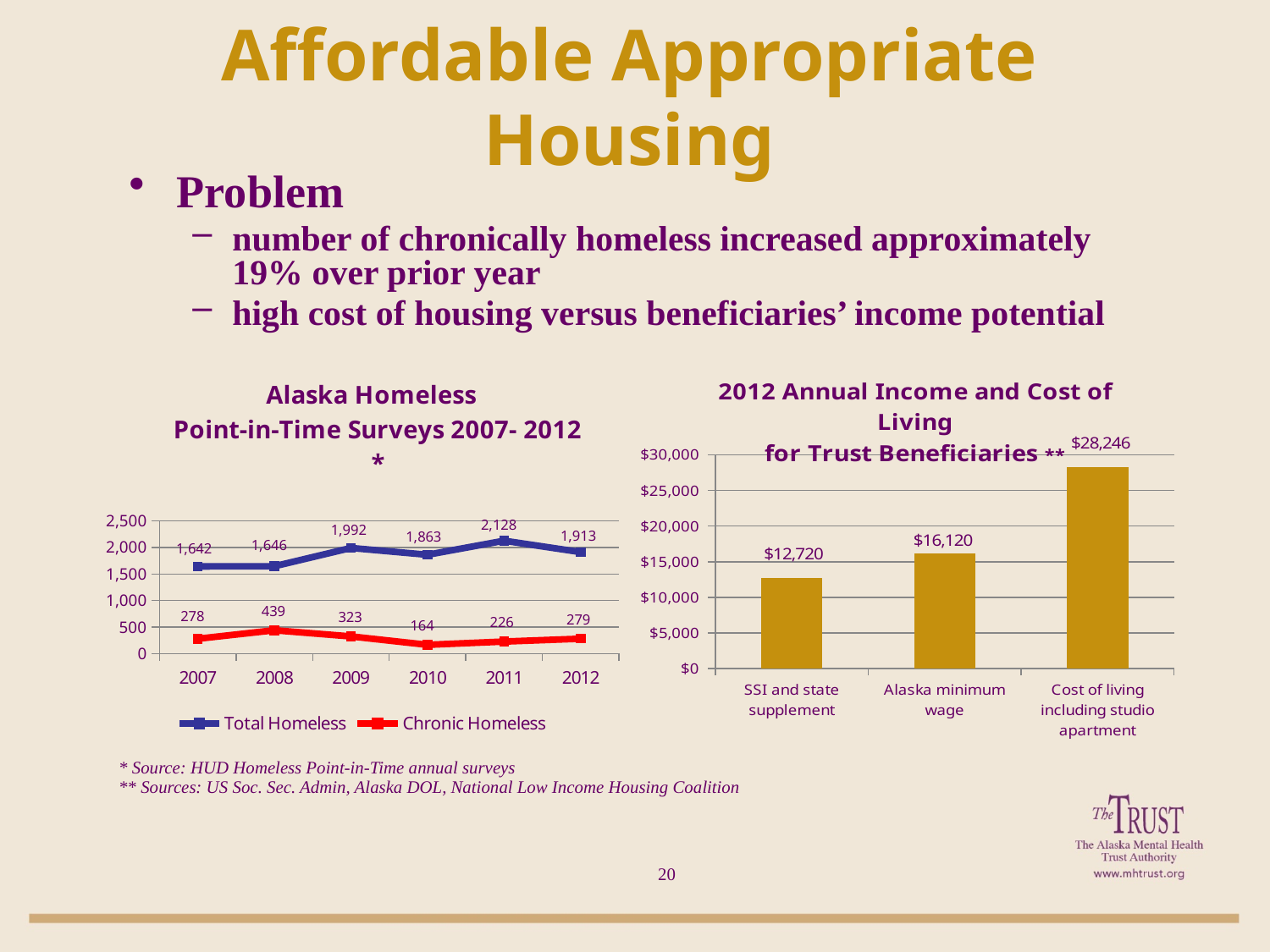
In the Alaska Homeless Point-in-Time Surveys chart, how many years are plotted on the x axis? 6 In the 2012 Annual Income and Cost of Living chart, what is the value for Alaska minimum wage? $16,120 In the 2012 Annual Income and Cost of Living chart, which category has the highest value? Cost of living including studio apartment In the 2012 Annual Income and Cost of Living chart, what is the difference between the cost of living including studio apartment and SSI and state supplement? $15,526 What kind of chart is the 2012 Annual Income and Cost of Living chart? Bar chart What kind of chart is the Alaska Homeless Point-in-Time Surveys chart? Line chart In the Alaska Homeless Point-in-Time Surveys chart, what is the difference between Total Homeless and Chronic Homeless in 2012? 1,634 In the Alaska Homeless Point-in-Time Surveys chart, which year has the highest Chronic Homeless value? 2008 In the Alaska Homeless Point-in-Time Surveys chart, what is the Chronic Homeless value for 2010? 164 In the Alaska Homeless Point-in-Time Surveys chart, how many series does the legend list? 2 In the Alaska Homeless Point-in-Time Surveys chart, which year has the lowest Total Homeless value? 2007 In the Alaska Homeless Point-in-Time Surveys chart, what is the Total Homeless value for 2011? 2,128